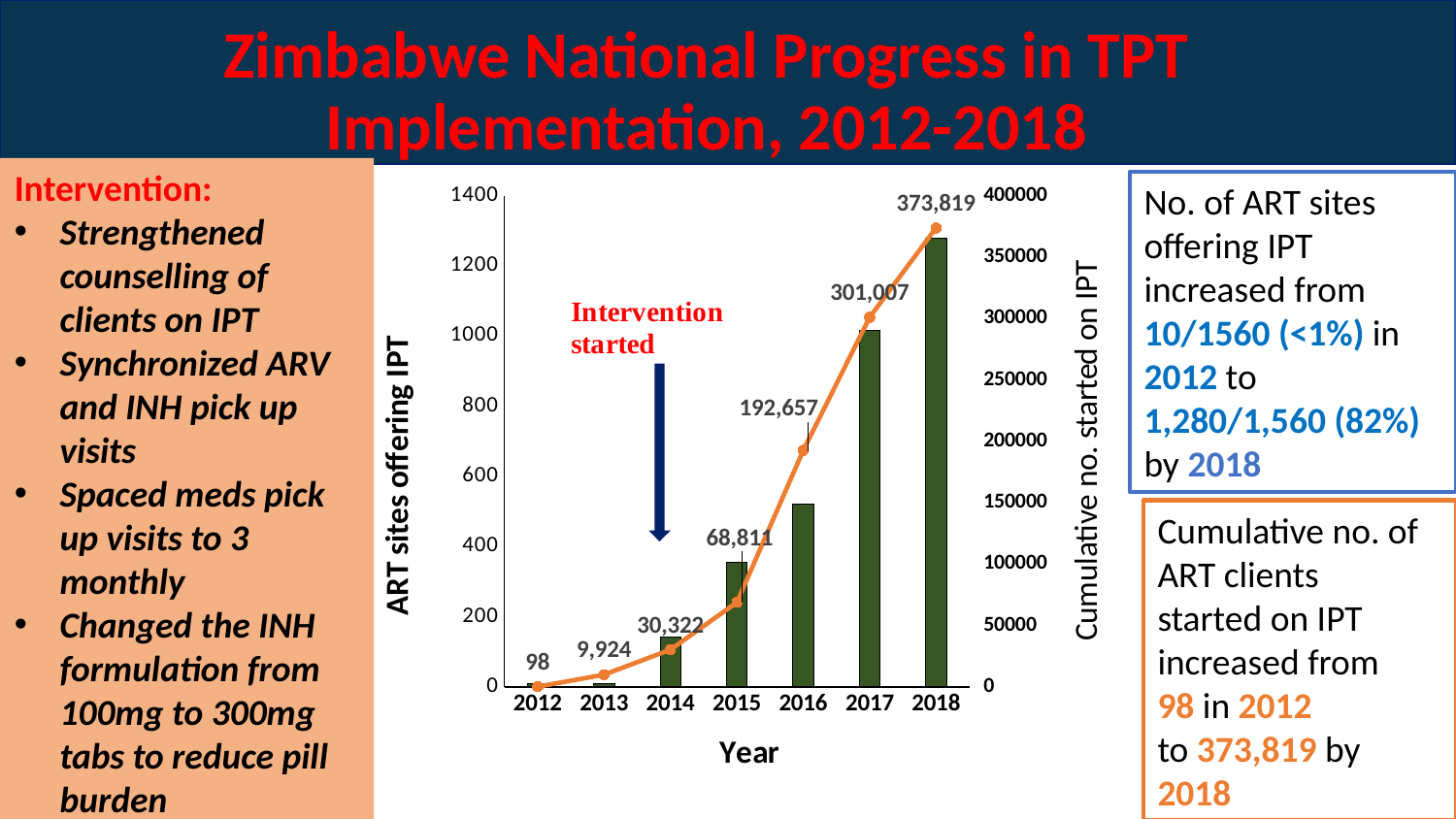
What is the cumulative number of clients started on IPT in 2013? 9,924 What is the difference between the cumulative number started on IPT in 2018 and in 2017? 72,812 Which year has the lowest cumulative number of clients started on IPT? 2012 Which year has the highest number of ART sites offering IPT? 2018 Is the number of ART sites offering IPT in 2015 greater or less than 400? less How many years are shown on the x axis of the chart? 7 Does the cumulative number of clients started on IPT rise or fall from 2012 to 2018? Rise What is the difference between the cumulative number started on IPT in 2015 and in 2014? 38,489 What kind of chart is used to show the ART sites offering IPT? Bar chart What is the cumulative number of clients started on IPT in 2015? 68,811 What is the cumulative number of clients started on IPT in 2018? 373,819 Is the number of ART sites offering IPT in 2018 greater or less than 1200? greater